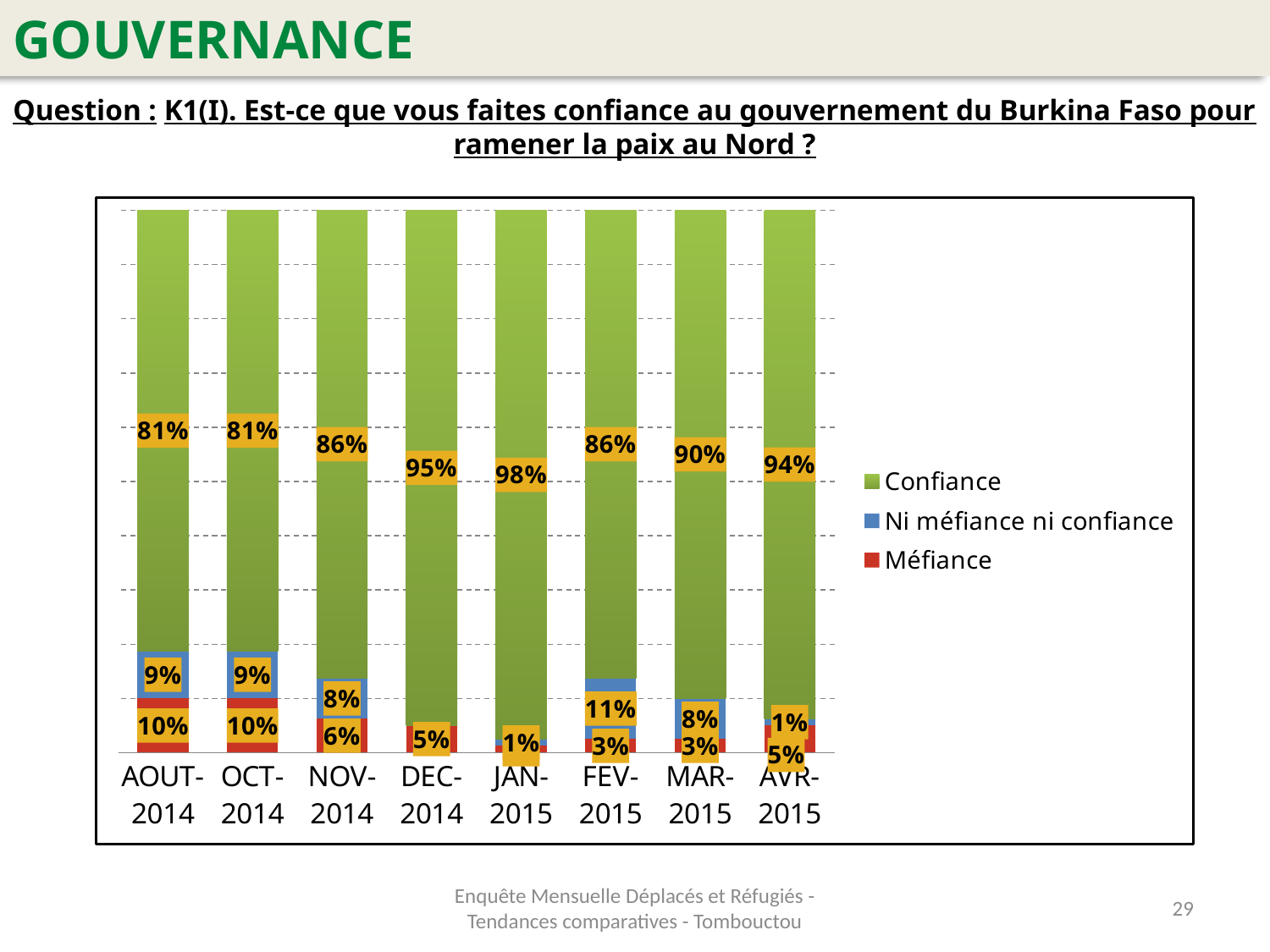
What is the Méfiance value for NOV-2014? 6% What is the Confiance value for DEC-2014? 95% Which month has the highest Ni méfiance ni confiance value? FEV-2015 What is the Ni méfiance ni confiance value for FEV-2015? 11% What is the difference between the Confiance value for JAN-2015 and for AOUT-2014? 17% Does the Confiance value rise or fall from AOUT-2014 to JAN-2015? Rise Which month has the highest Confiance value? JAN-2015 How many months are shown on the x axis? 8 How many series does the legend list? 3 Which is larger, the Confiance value for MAR-2015 or for AVR-2015? AVR-2015 Which month has the lowest Méfiance value? JAN-2015 What kind of chart is shown on the slide? Stacked bar chart